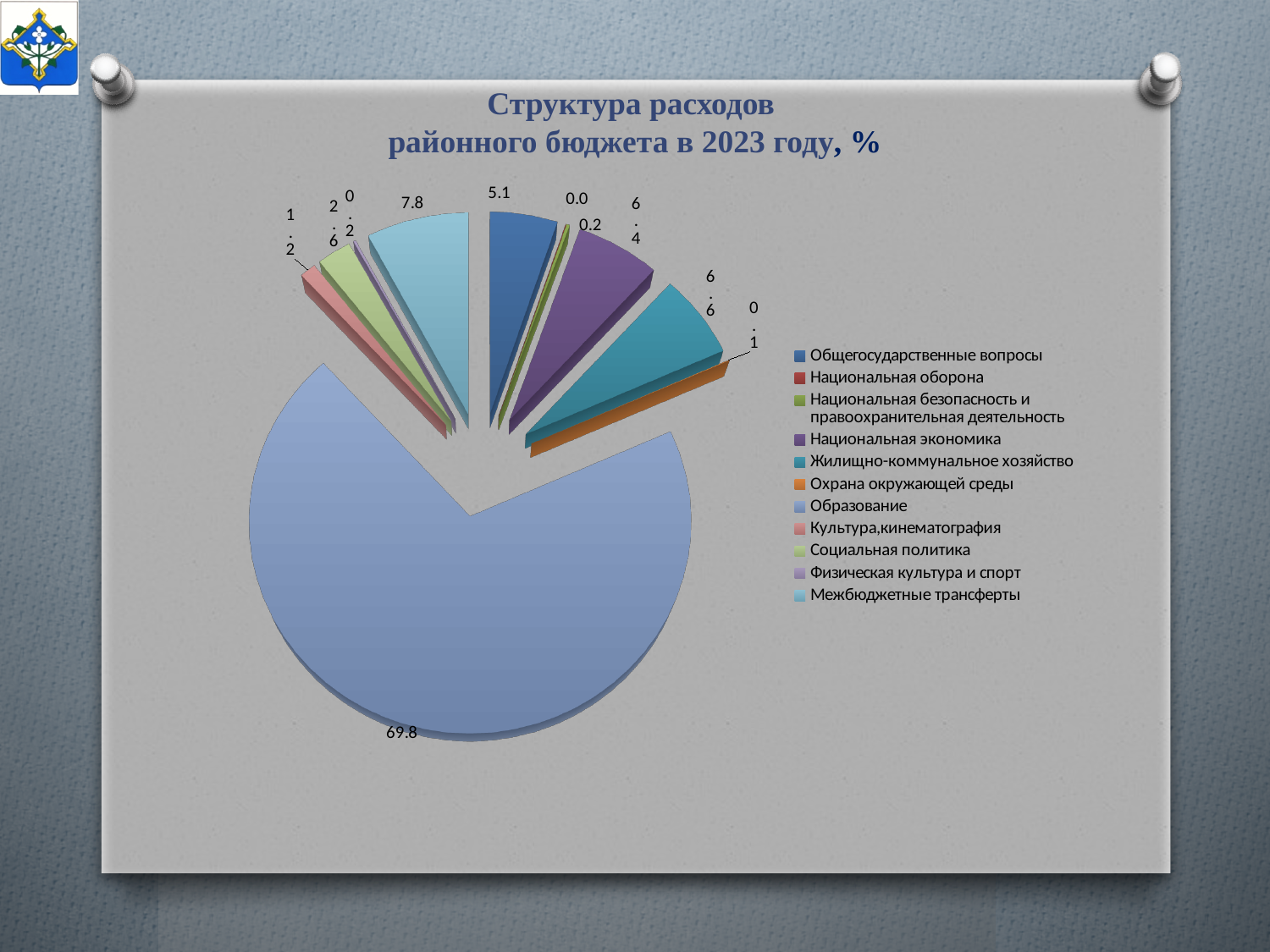
What is the value for Межбюджетные трансферты? 7.8 What is the value for Социальная политика? 2.6 What is the value for Образование? 69.8 What is the value for Жилищно-коммунальное хозяйство? 6.6 Which is larger, Жилищно-коммунальное хозяйство or Национальная экономика? Жилищно-коммунальное хозяйство What type of chart is shown on the slide? pie chart What is the value for Общегосударственные вопросы? 5.1 How many categories does the legend list? 11 Which category has the smallest value? Национальная оборона What is the value for Национальная экономика? 6.4 What is the difference between the values for Межбюджетные трансферты and Общегосударственные вопросы? 2.7 Which category has the largest share of the pie? Образование